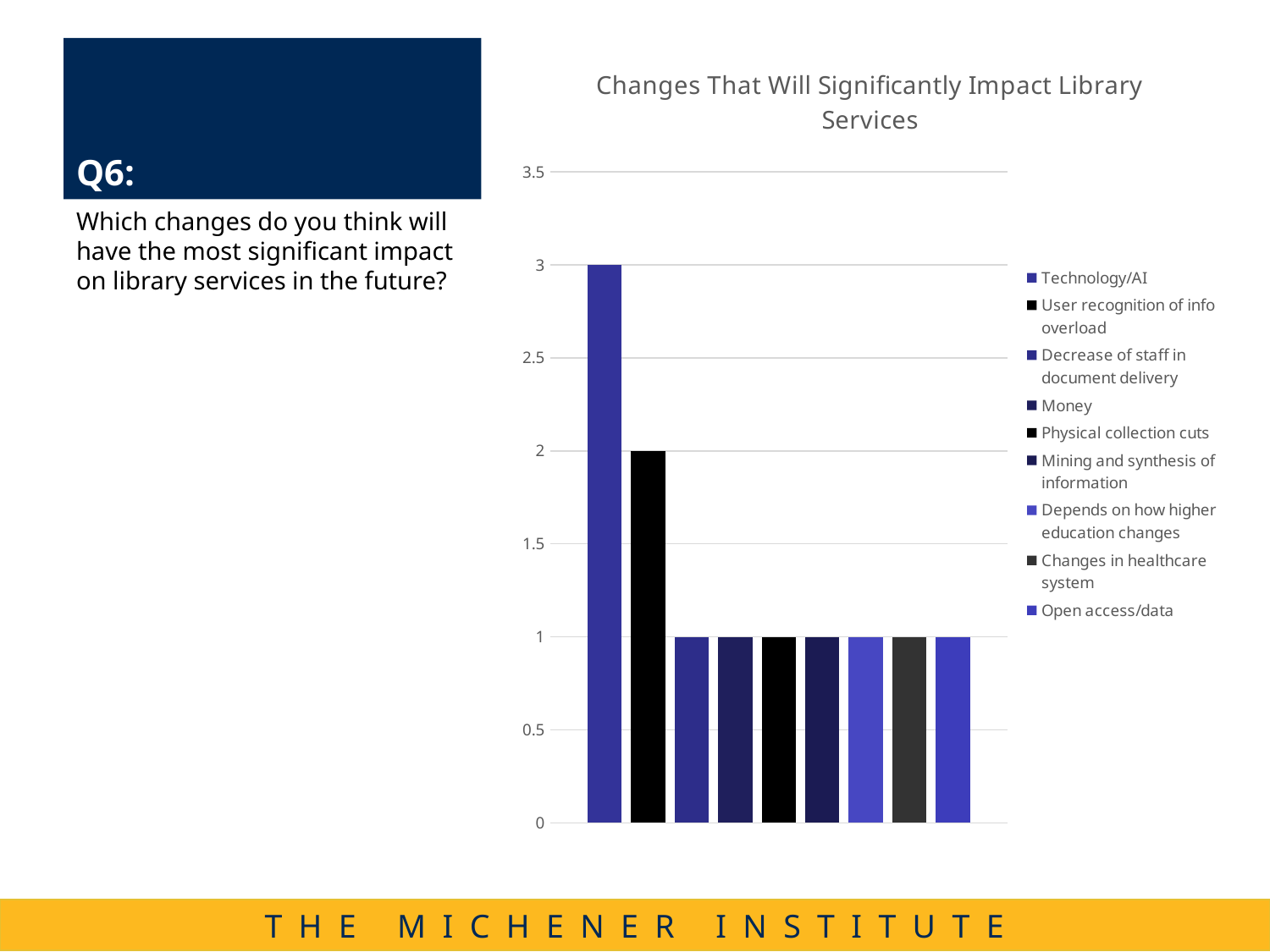
Which category has the highest value? Technology/AI What is the value for Technology/AI? 3 What is the difference between the values for Technology/AI and User recognition of info overload? 1 Which is larger, the value for Technology/AI or the value for Open access/data? Technology/AI What is the value for Money? 1 How many categories have a value of 1? 7 What is the title of the chart? Changes That Will Significantly Impact Library Services What kind of chart is shown on the slide? bar chart What is the value for User recognition of info overload? 2 How many series does the legend list? 9 How many bars are plotted in the chart? 9 Is the value for Technology/AI greater or less than 2.5? greater